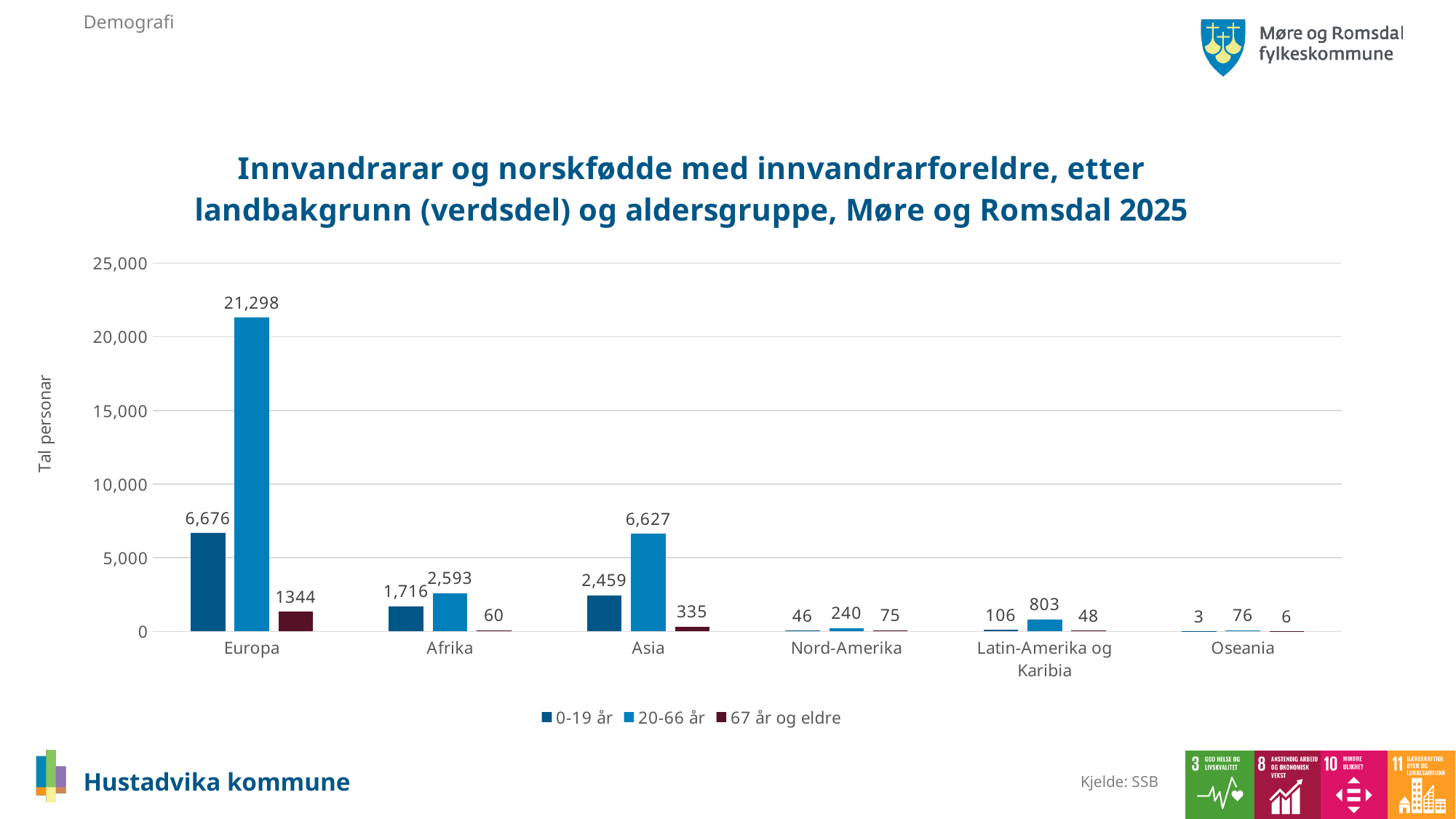
Which is larger: the 0-19 år value for Afrika or the 0-19 år value for Asia? Asia What is the difference between the 20-66 år and 0-19 år values for Afrika? 877 Which region has the lowest value for the 0-19 år series? Oseania How many world regions (categories) are shown on the x axis? 6 What type of chart is shown on the slide? bar chart What is the difference between the 20-66 år values for Europa and Asia? 14,671 What is the value for the 20-66 år series for Europa? 21,298 What is the value for the 0-19 år series for Latin-Amerika og Karibia? 106 Which region has the highest value for the 20-66 år series? Europa How many series does the legend list? 3 What is the value for the 67 år og eldre series for Asia? 335 Is the 20-66 år value for Europa greater or less than 20,000? greater